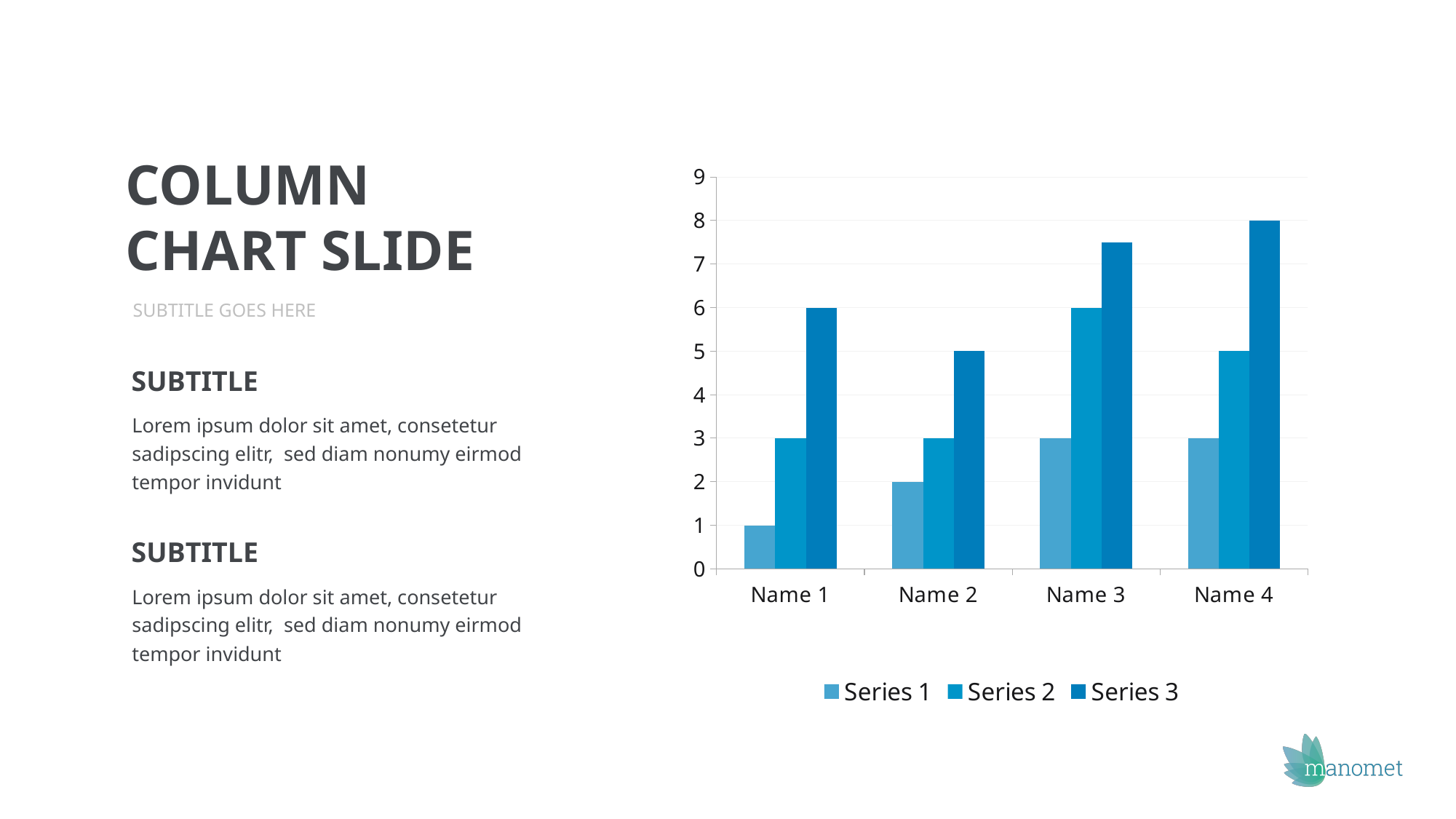
What is the value of Series 3 for Name 4? 8 Which category has the highest Series 3 value? Name 4 Which category has the lowest Series 1 value? Name 1 What is the difference between the Series 3 value and the Series 1 value for Name 4? 5 What is the value of Series 2 for Name 3? 6 What type of chart is shown on the slide? bar chart Which is larger for Name 2: the Series 2 value or the Series 3 value? Series 3 Does the Series 1 value rise or fall from Name 1 to Name 3? rise Is the value of Series 3 for Name 3 greater or less than 7? greater How many categories are shown on the x axis? 4 How many series does the legend list? 3 What is the value of Series 1 for Name 1? 1